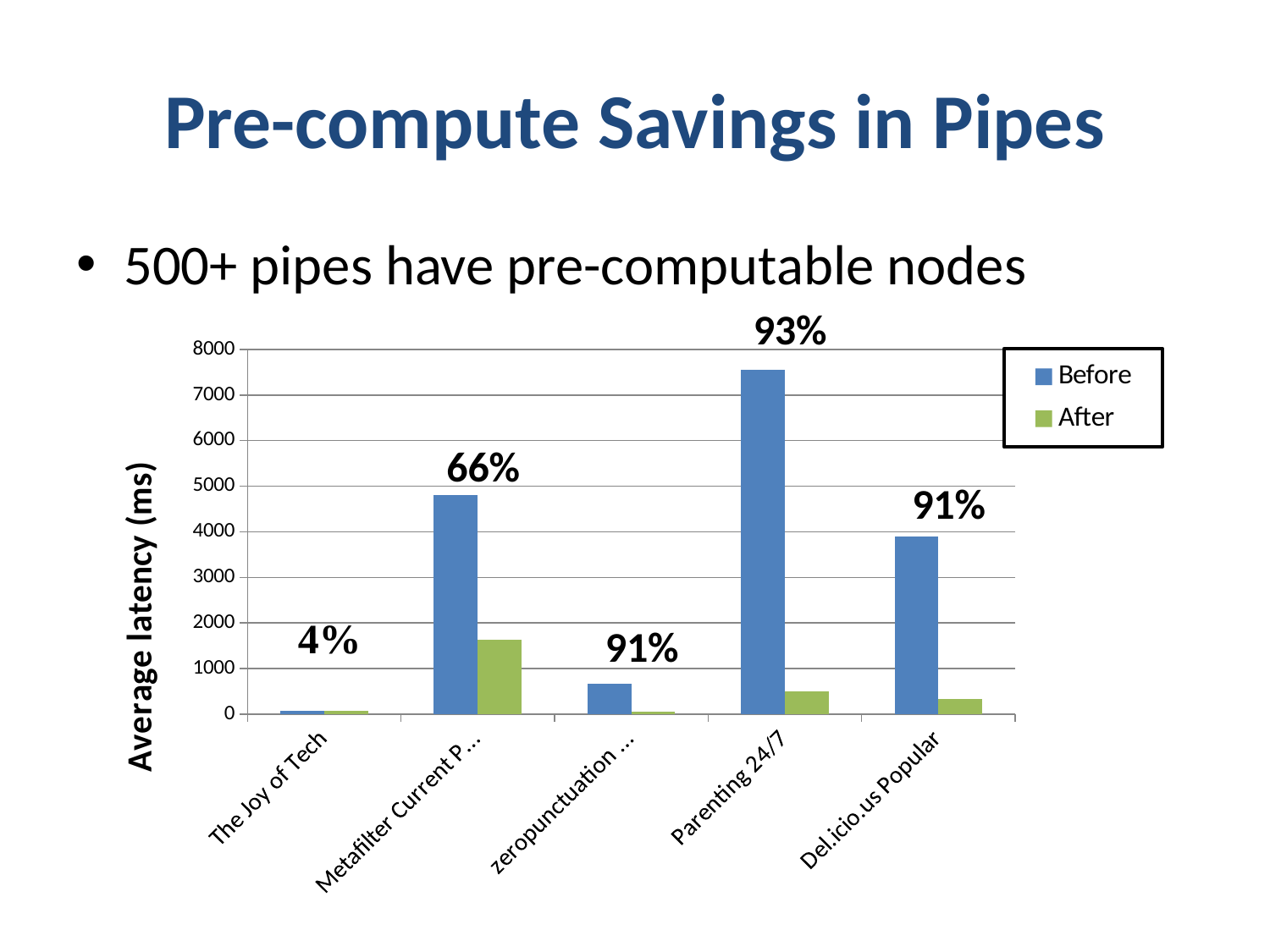
Is the After value for Parenting 24/7 greater or less than 1000? less Is the Before value for Del.icio.us Popular greater or less than 5000? less What is the title of the y axis? Average latency (ms) Which category has the lowest Before value? The Joy of Tech What percentage label is shown above The Joy of Tech bars? 4% What kind of chart is shown on the slide? bar chart How many categories are shown on the x axis? 5 Is the Before value for Parenting 24/7 greater or less than 7000? greater Which category has the highest Before value? Parenting 24/7 What percentage label is shown above the Parenting 24/7 bars? 93% For Parenting 24/7, which is larger, the Before value or the After value? Before How many series does the legend list? 2